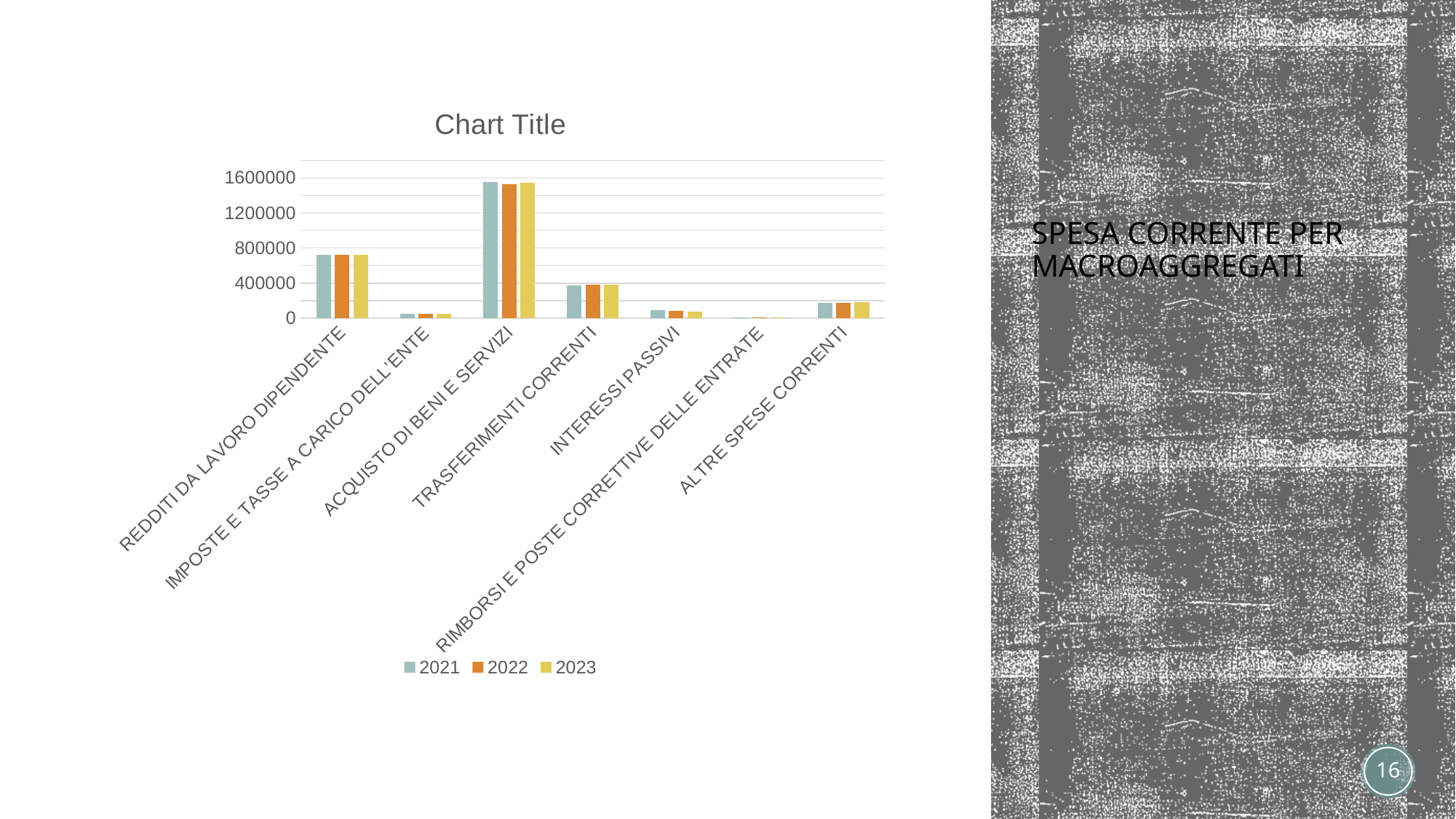
What kind of chart is shown on the slide? bar chart Which is larger in 2023: REDDITI DA LAVORO DIPENDENTE or TRASFERIMENTI CORRENTI? REDDITI DA LAVORO DIPENDENTE Which is larger in 2022: ALTRE SPESE CORRENTI or INTERESSI PASSIVI? ALTRE SPESE CORRENTI Which category has the lowest values in the chart? RIMBORSI E POSTE CORRETTIVE DELLE ENTRATE Is the 2023 value for INTERESSI PASSIVI greater or less than 400000? less Is the 2021 value for REDDITI DA LAVORO DIPENDENTE greater or less than 400000? greater Is the 2021 value for ACQUISTO DI BENI E SERVIZI greater or less than 1200000? greater How many series does the chart's legend list? 3 How many categories are shown on the x axis of the chart? 7 What are the legend entries of the chart? 2021, 2022, 2023 Which category has the highest values in the chart? ACQUISTO DI BENI E SERVIZI